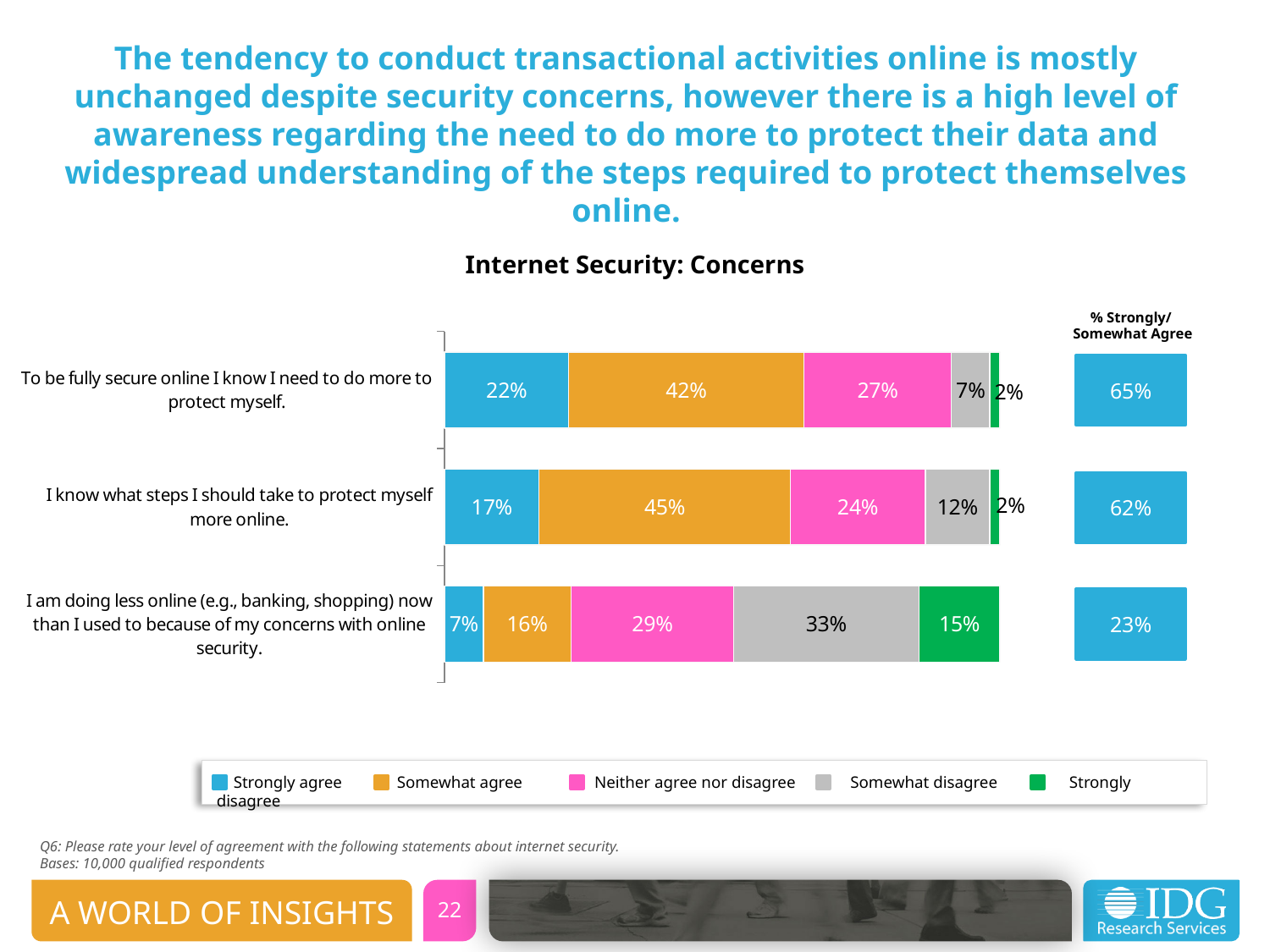
Which statement has the highest Somewhat agree percentage? I know what steps I should take to protect myself more online. What is the title of the chart? Internet Security: Concerns What is the total of the stacked bar for "To be fully secure online I know I need to do more to protect myself."? 100% Which statement has a larger Strongly disagree percentage: "I am doing less online (e.g., banking, shopping) now than I used to because of my concerns with online security." or "To be fully secure online I know I need to do more to protect myself."? I am doing less online (e.g., banking, shopping) now than I used to because of my concerns with online security. How many series does the legend list? 5 What is the % Strongly/Somewhat Agree figure shown for the statement "I am doing less online (e.g., banking, shopping) now than I used to because of my concerns with online security."? 23% Which statement has the lowest Strongly agree percentage? I am doing less online (e.g., banking, shopping) now than I used to because of my concerns with online security. How many statements are plotted in the chart? 3 What kind of chart is shown on the slide? Stacked bar chart What percentage of respondents somewhat disagree with the statement "I am doing less online (e.g., banking, shopping) now than I used to because of my concerns with online security."? 33% What is the difference between the Somewhat agree percentages for "I know what steps I should take to protect myself more online." and "To be fully secure online I know I need to do more to protect myself."? 3 percentage points What percentage of respondents strongly agree with the statement "I know what steps I should take to protect myself more online."? 17%